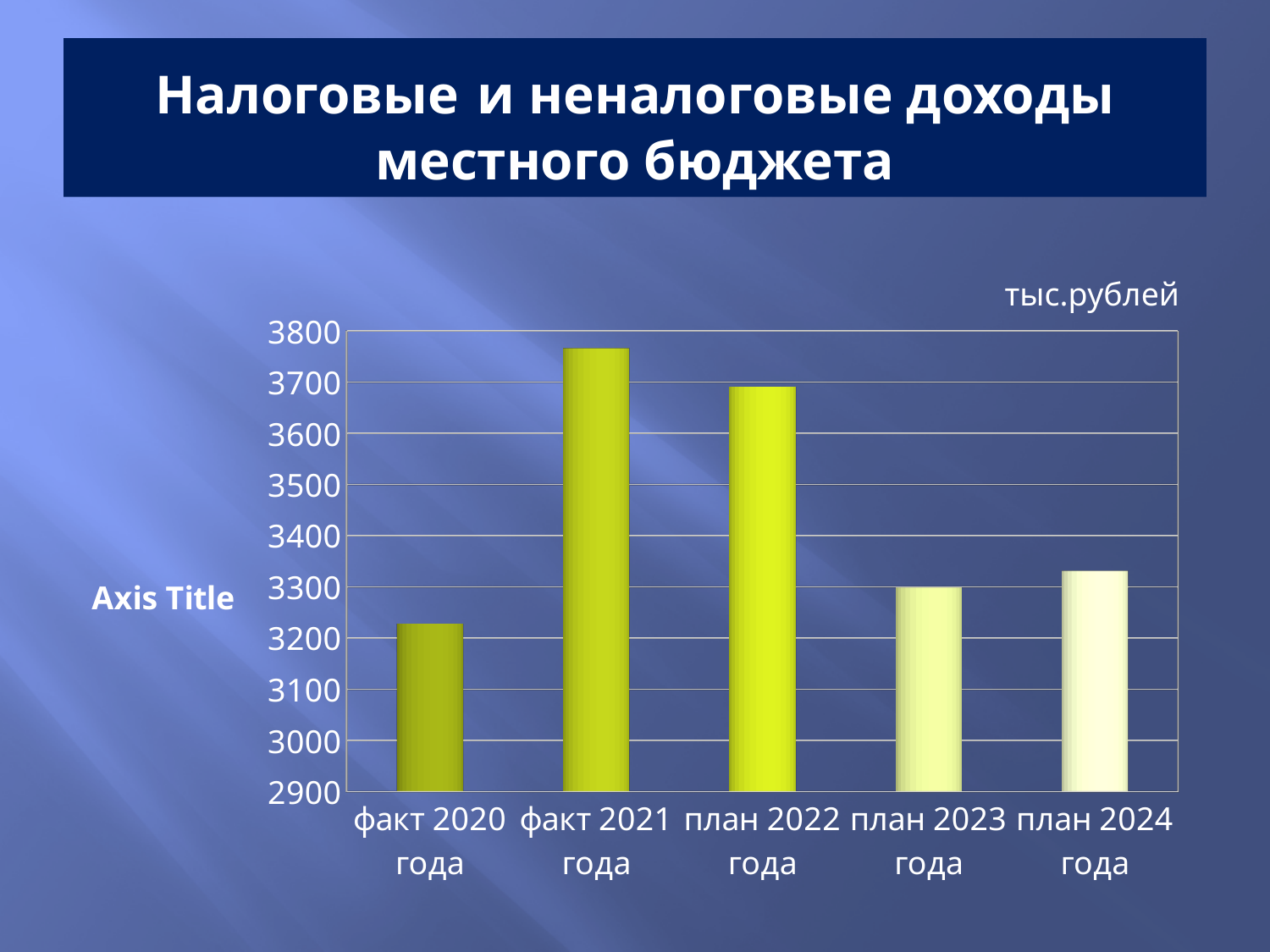
How many categories are shown on the x axis of the chart? 5 Which is larger, the value for факт 2021 года or the value for план 2022 года? факт 2021 года What is the title of the slide above the chart? Налоговые и неналоговые доходы местного бюджета Which category has the lowest bar in the chart? факт 2020 года What unit is indicated above the chart? тыс.рублей Which category has the highest bar in the chart? факт 2021 года Is the value for факт 2020 года greater or less than 3300? less Is the value for план 2022 года greater or less than 3600? greater What kind of chart is shown on the slide? bar chart Is the value for факт 2021 года greater or less than 3700? greater Which is larger, the value for факт 2020 года or the value for план 2023 года? план 2023 года